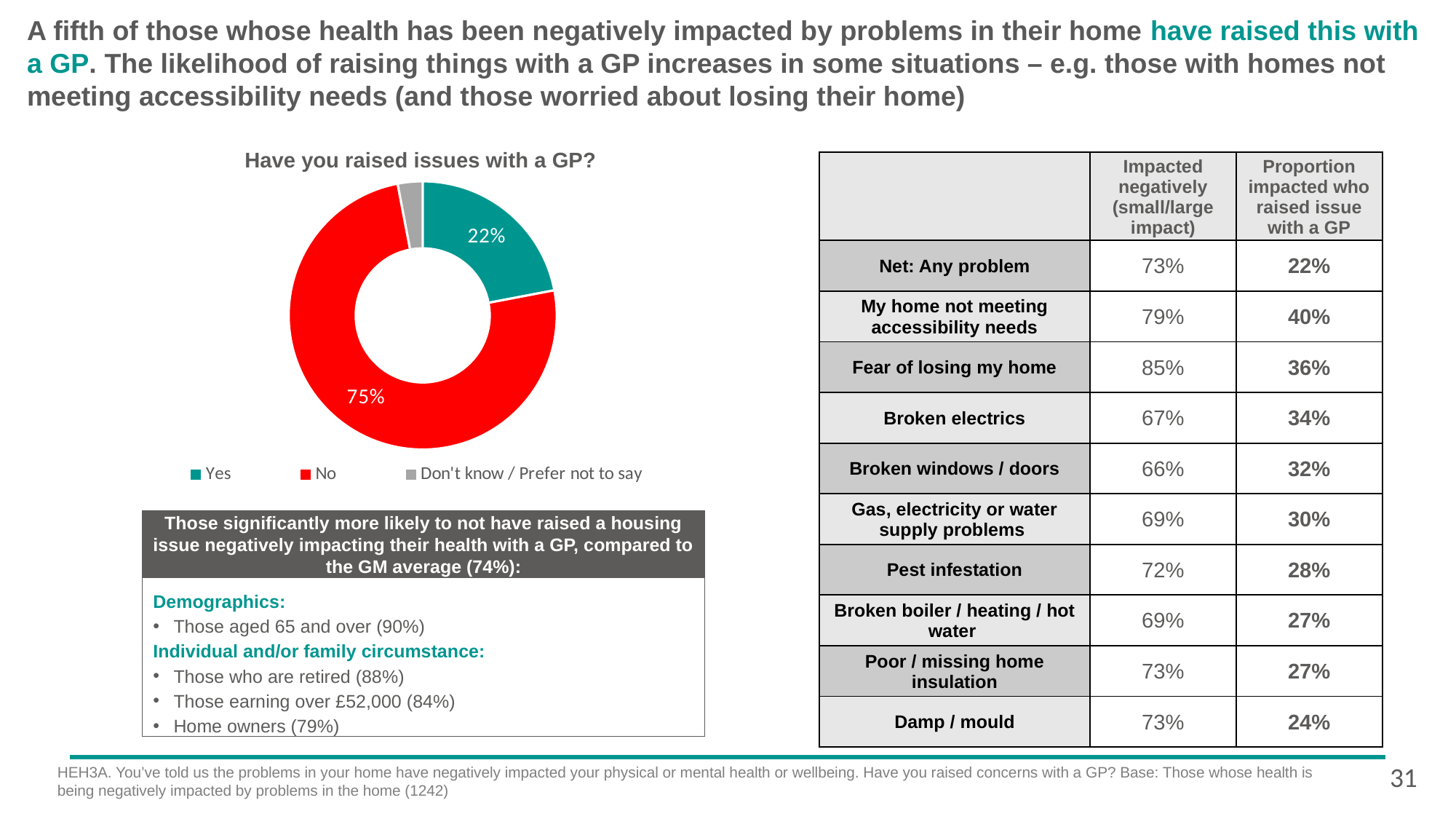
What is the difference in percentage points between the "No" and "Yes" slices? 53 percentage points What type of chart is shown on the slide? Pie chart (donut) What percentage of respondents answered "No" in the chart? 75% Which response has the largest share of the chart? No Which is larger in the chart, the "Yes" slice or the "No" slice? No Which response has the smallest share of the chart? Don't know / Prefer not to say Is the share for "No" greater or less than 50%? greater What is the title of the chart? Have you raised issues with a GP? What percentage of respondents answered "Yes" in the chart? 22% Is the share for "Yes" greater or less than 50%? less What colour is the "No" slice in the chart? Red How many categories does the chart's legend list? 3